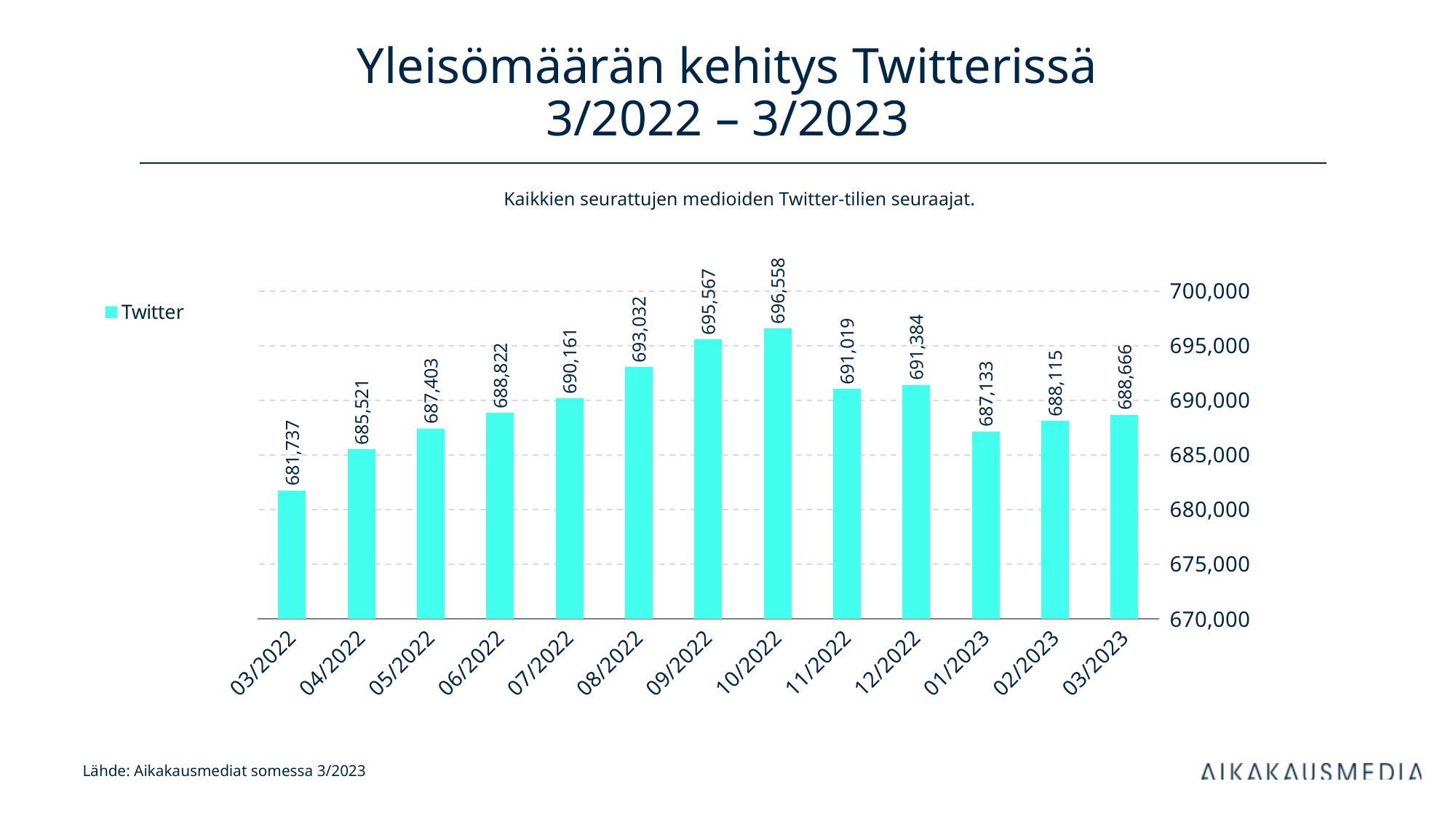
Is the value for 09/2022 greater or less than 695,000? greater How many series does the legend list? 1 What is the value for 03/2022? 681,737 What is the value for 03/2023? 688,666 Which is larger, the value for 12/2022 or the value for 11/2022? 12/2022 What is the value for 10/2022? 696,558 What kind of chart is shown on the slide? bar chart What is the difference between the values for 10/2022 and 03/2022? 14,821 Which month has the lowest value? 03/2022 Which month has the highest value? 10/2022 How many months are shown on the x axis? 13 Do the values rise or fall from 03/2022 to 10/2022? rise